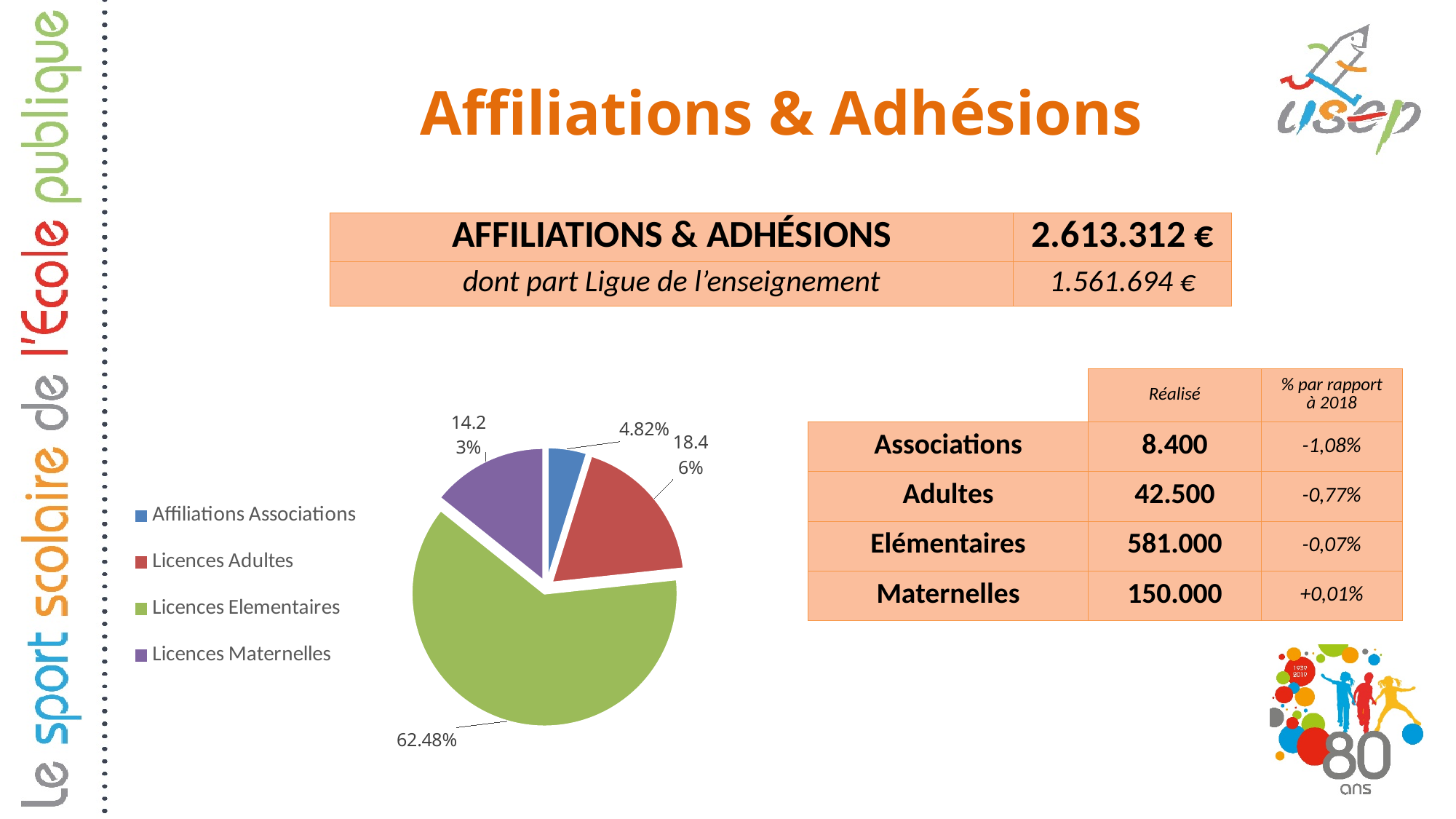
How many entries does the pie chart's legend list? 4 Which slice is larger in the pie chart: Licences Adultes or Licences Maternelles? Licences Adultes Which category has the largest slice in the pie chart? Licences Elementaires What share of the pie does Licences Maternelles represent? 14.23% What percentage of the pie chart is Affiliations Associations? 4.82% What percentage of the pie chart is Licences Elementaires? 62.48% What kind of chart is shown on the slide? pie chart What colour is the Licences Elementaires slice in the pie chart? green What percentage of the pie chart is Licences Adultes? 18.46% Which category has the smallest slice in the pie chart? Affiliations Associations What is the difference in percentage points between the Licences Elementaires slice and the Affiliations Associations slice? 57.66 How many slices does the pie chart have? 4